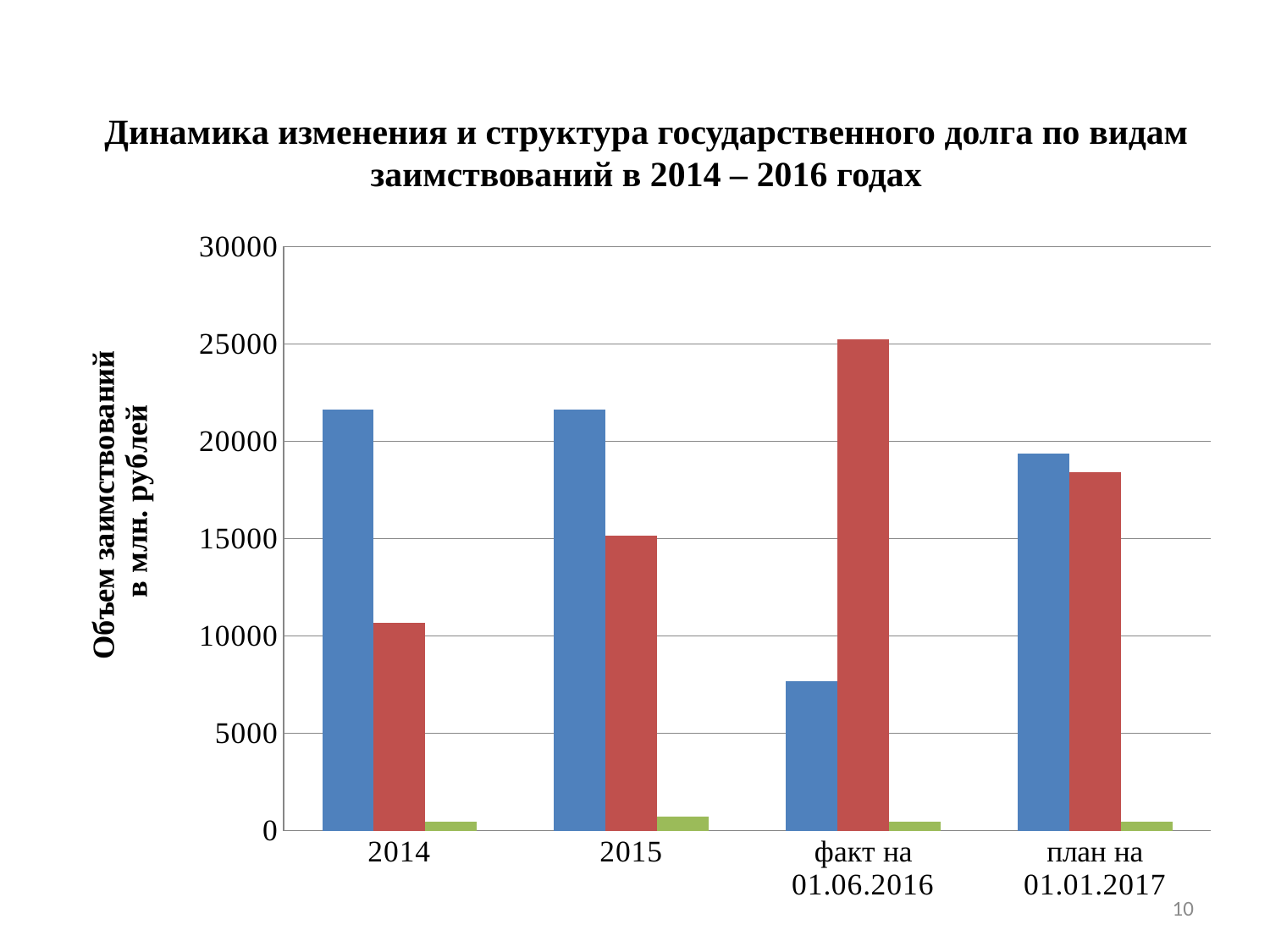
Is the value of the blue bar for 2014 greater or less than 20000? greater What is the label of the vertical axis of the chart? Объем заимствований в млн. рублей Is the value of the red bar for план на 01.01.2017 greater or less than 20000? less For факт на 01.06.2016, which bar is larger, the blue one or the red one? the red one In which category is the blue bar the lowest? факт на 01.06.2016 How many bars are plotted for each category on the chart? 3 What kind of chart is shown on the slide? bar chart In which category is the red bar the highest? факт на 01.06.2016 Is the value of the blue bar for факт на 01.06.2016 greater or less than 10000? less How many categories are shown on the x axis of the chart? 4 For 2014, which bar is larger, the blue one or the red one? the blue one